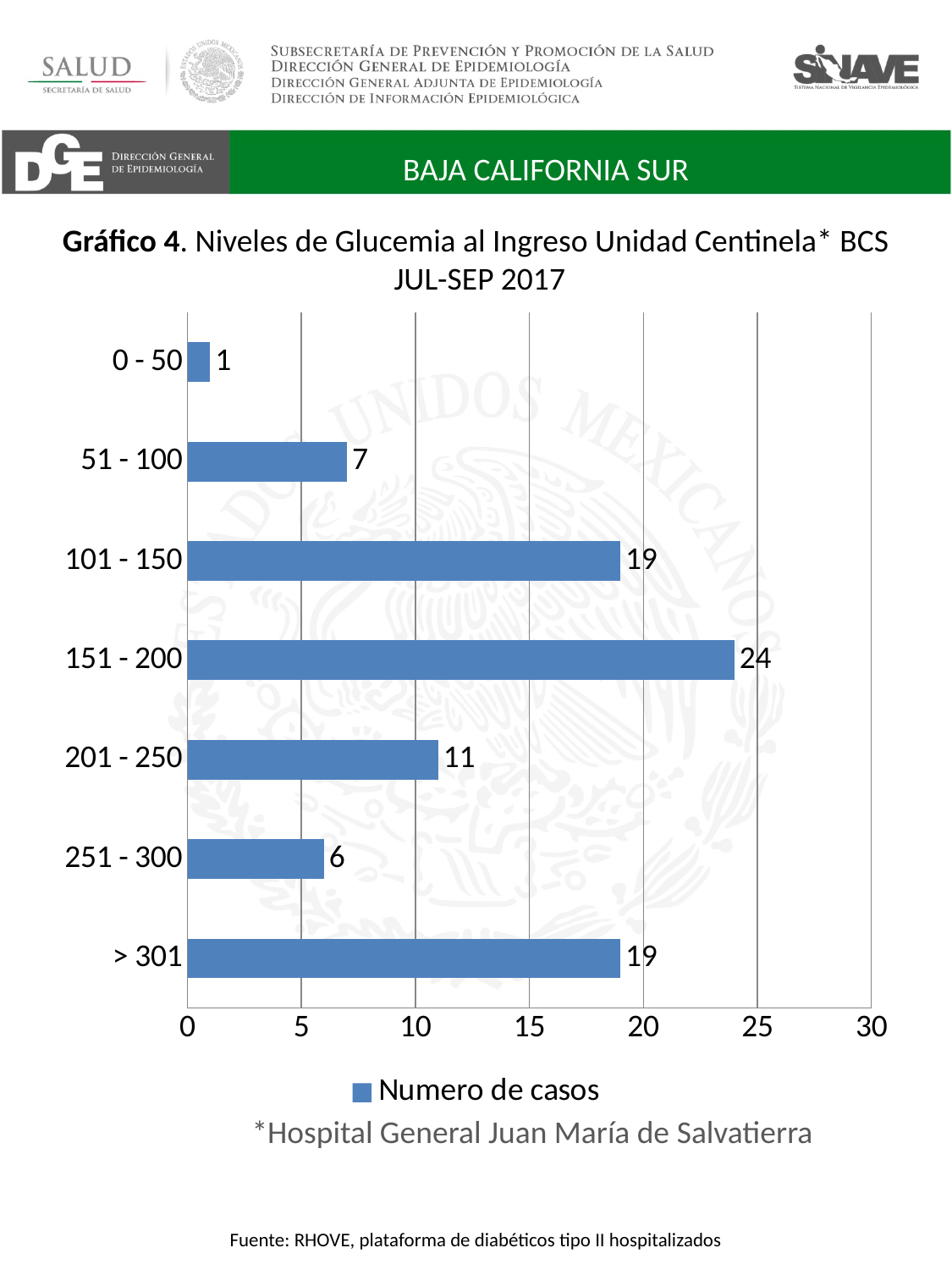
How many series does the legend list? 1 What is the difference in number of cases between the 151 - 200 and 101 - 150 categories? 5 What is the number of cases for the 201 - 250 category? 11 What is the legend entry for the series shown in the chart? Numero de casos How many glucose level categories are shown in the chart? 7 What is the number of cases for the 0 - 50 category? 1 What is the number of cases for the 151 - 200 glucose level category? 24 Which glucose level category has the highest number of cases? 151 - 200 What kind of chart is shown on the slide? Bar chart Is the value for the 201 - 250 category greater or less than 10? greater Which glucose level category has the lowest number of cases? 0 - 50 Which has more cases, the 51 - 100 category or the 251 - 300 category? 51 - 100